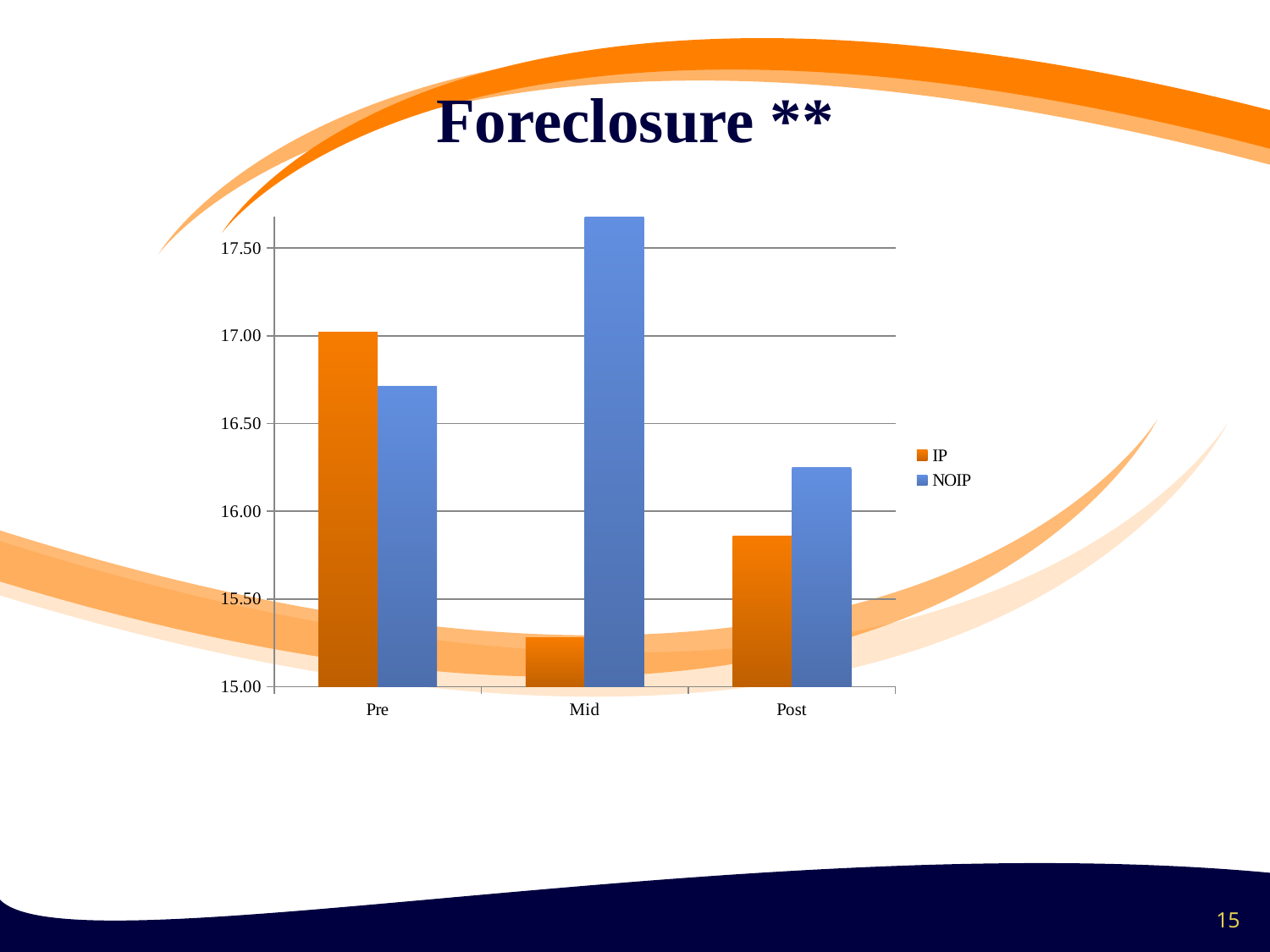
What kind of chart is shown on the slide? bar chart For the Pre category, which series has the larger value, IP or NOIP? IP For the Post category, which series has the larger value, IP or NOIP? NOIP Does the IP value rise or fall from Pre to Mid? fall Which category has the lowest IP value? Mid Is the IP value for Mid greater or less than 15.50? less How many categories are shown on the x axis? 3 Which category has the highest NOIP value? Mid Is the IP value for Post greater or less than 16.00? less Is the NOIP value for Mid greater or less than 17.50? greater Which series has the highest bar in the chart? NOIP How many series does the legend list? 2